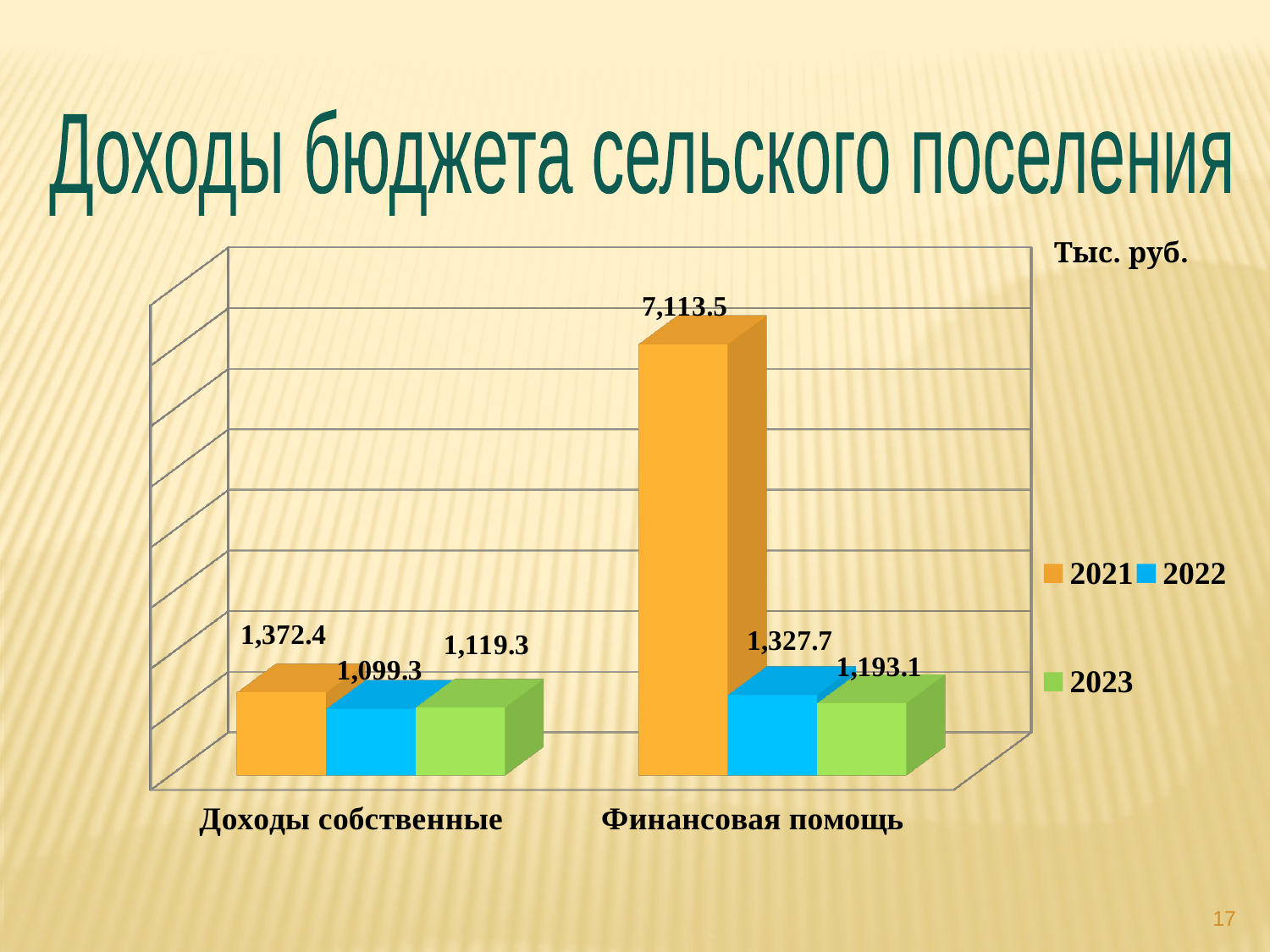
How many series does the legend list? 3 What is the difference between the 2021 and 2022 values in the Финансовая помощь category? 5,785.8 What is the value for 2021 in the Доходы собственные category? 1,372.4 Which year has the highest value in the Финансовая помощь category? 2021 Which is larger: the 2023 value for Доходы собственные or the 2023 value for Финансовая помощь? Финансовая помощь Which year has the lowest value in the Доходы собственные category? 2022 What is the value for 2021 in the Финансовая помощь category? 7,113.5 What kind of chart is shown on the slide? Bar chart What is the value for 2022 in the Финансовая помощь category? 1,327.7 What is the value for 2023 in the Доходы собственные category? 1,119.3 How many categories are shown on the x axis? 2 What is the difference between the 2021 and 2022 values in the Доходы собственные category? 273.1